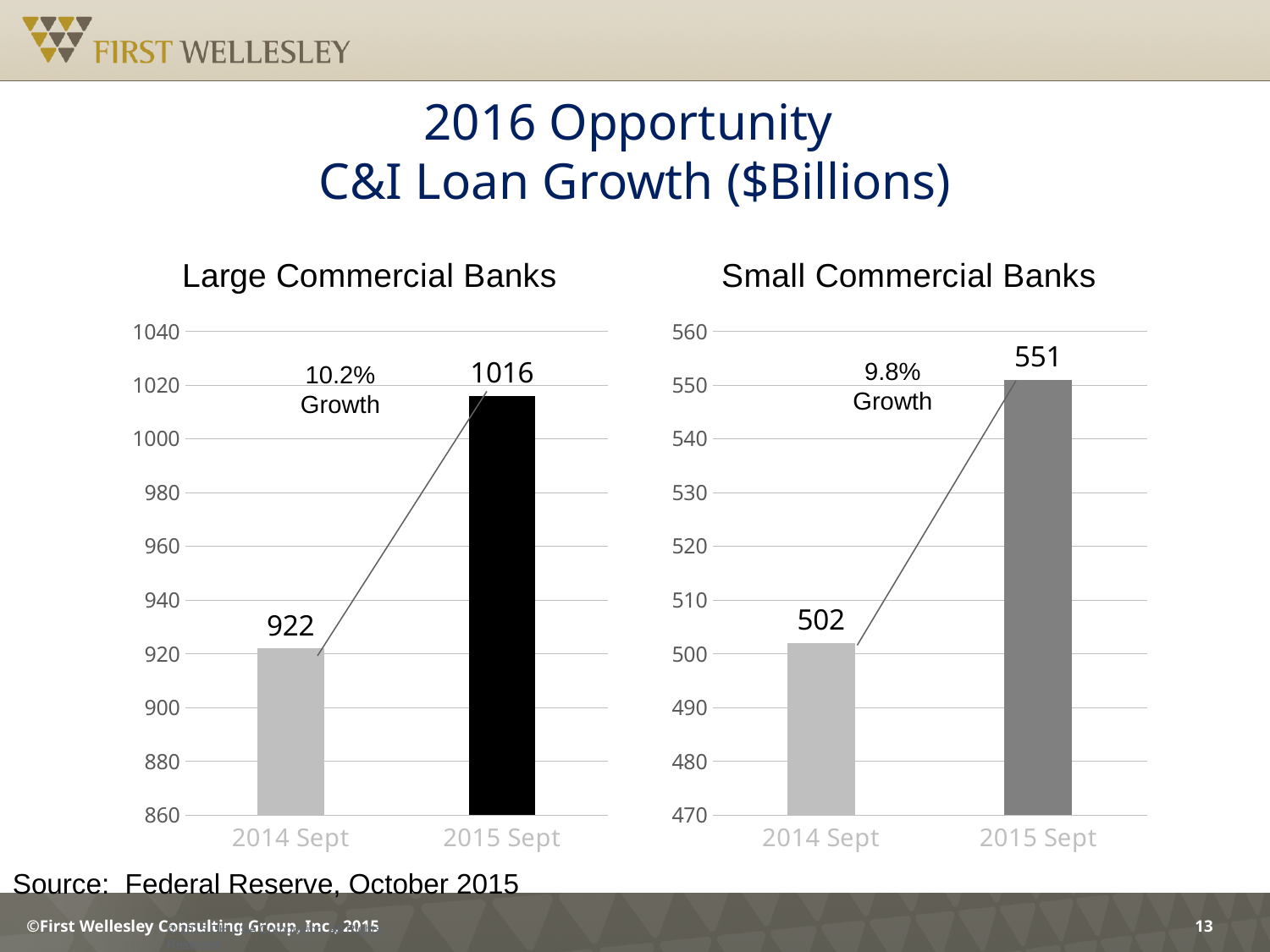
What growth percentage is annotated on the Small Commercial Banks chart? 9.8% In the Small Commercial Banks chart, what is the difference between the 2015 Sept and 2014 Sept values? 49 In the Large Commercial Banks chart, what is the value for 2015 Sept? 1016 In the Small Commercial Banks chart, what is the value for 2015 Sept? 551 In the Small Commercial Banks chart, which category has the highest value? 2015 Sept In the Small Commercial Banks chart, what is the value for 2014 Sept? 502 In the Large Commercial Banks chart, do the values rise or fall from 2014 Sept to 2015 Sept? rise How many categories are shown in the Small Commercial Banks chart? 2 In the Large Commercial Banks chart, which category has the lowest value? 2014 Sept In the Large Commercial Banks chart, what is the difference between the 2015 Sept and 2014 Sept values? 94 In the Large Commercial Banks chart, what is the value for 2014 Sept? 922 What kind of chart is the Large Commercial Banks chart? bar chart